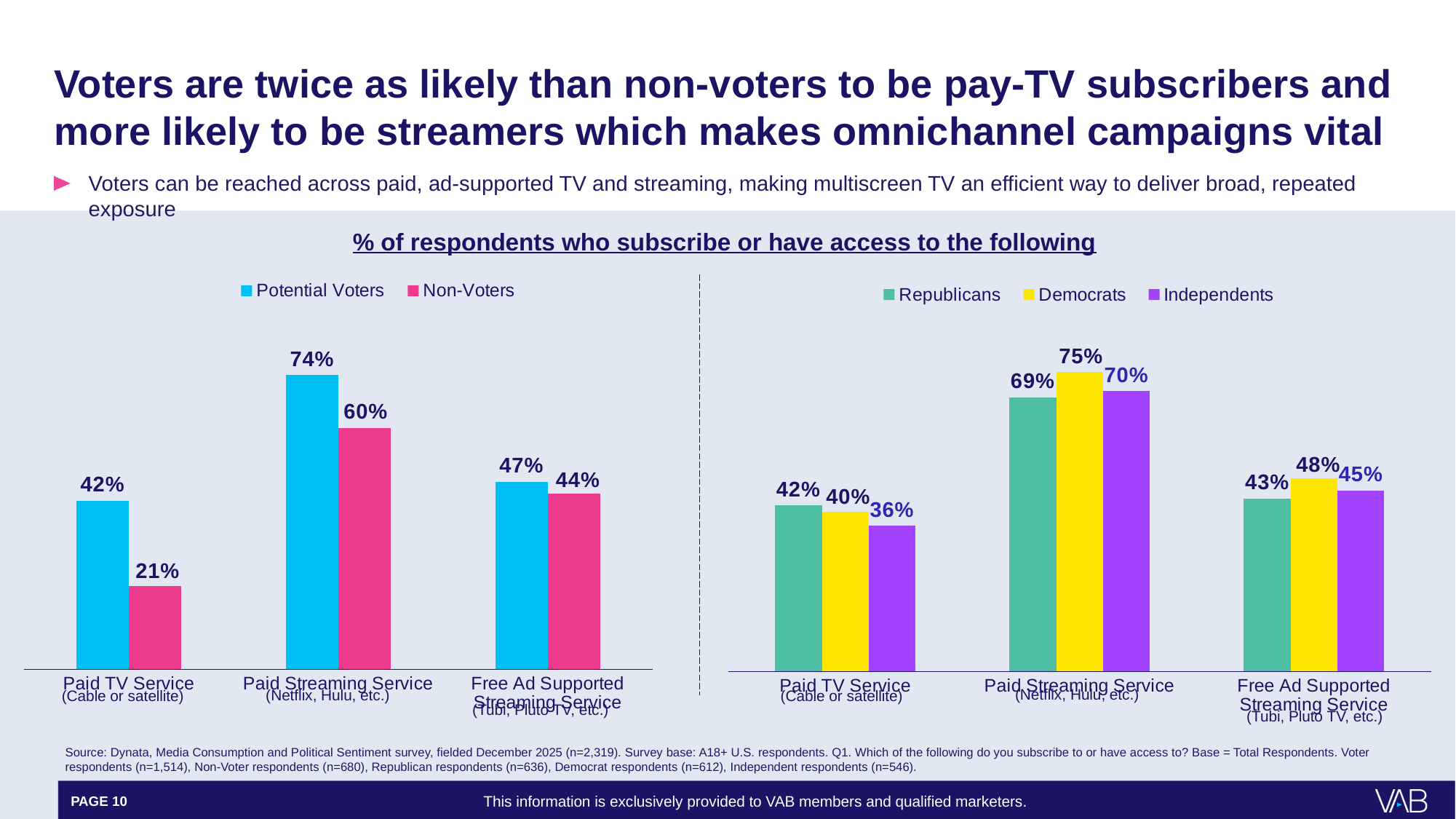
In the left chart, what percentage of Potential Voters subscribe to a Paid TV Service? 42% What kind of chart is the left chart? Bar chart In the left chart, what percentage of Non-Voters subscribe to a Paid Streaming Service? 60% In the right chart, which group has the highest value for Free Ad Supported Streaming Service? Democrats In the right chart, which is larger for Paid Streaming Service: Republicans or Independents? Independents In the right chart, what percentage of Independents subscribe to a Paid TV Service? 36% In the right chart, what percentage of Democrats subscribe to a Paid Streaming Service? 75% In the left chart, which category has the lowest value for Non-Voters? Paid TV Service How many series does the legend of the right chart list? 3 In the right chart, what is the difference between Republicans and Independents for Paid TV Service? 6% In the left chart, which category has the highest value for Potential Voters? Paid Streaming Service In the left chart, what is the difference between Potential Voters and Non-Voters for Paid TV Service? 21%